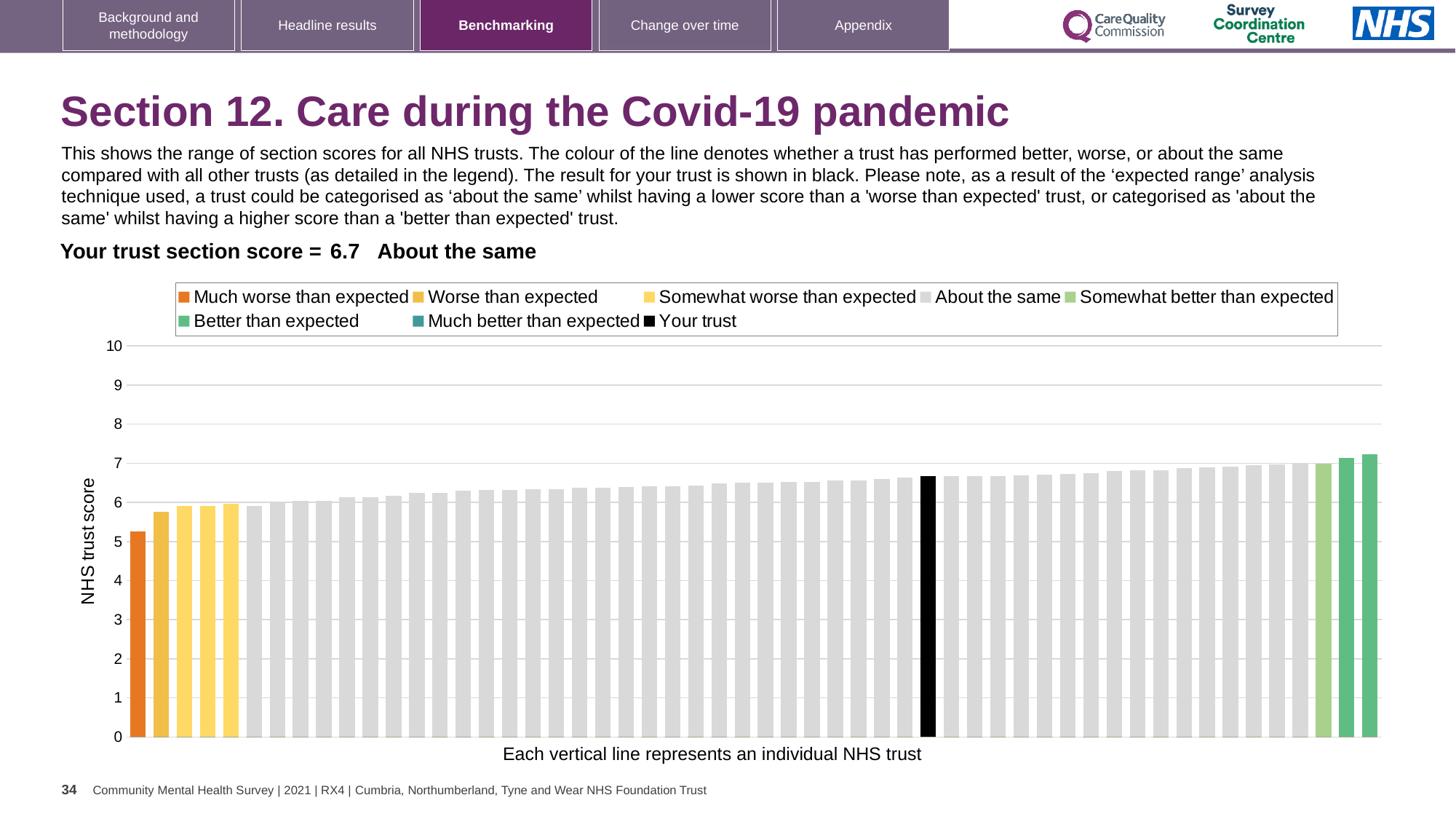
How many entries does the chart legend list? 8 Which is larger: the score for your trust (black bar) or the score of the orange bar on the far left? your trust Which legend category does the highest bar belong to? Better than expected Which benchmarking category is your trust placed in for this section? About the same What is the label on the vertical axis of the chart? NHS trust score Do the bar values rise or fall from left to right along the x axis? rise What kind of chart is shown on the slide? bar chart Is the value of the highest bar (on the far right) greater or less than 7? greater Which legend category does the lowest bar belong to? Much worse than expected What is the section score for your trust shown on the slide? 6.7 How many bars are coloured orange (Much worse than expected)? 1 Is the value of the lowest bar (the orange bar on the far left) greater or less than 6? less